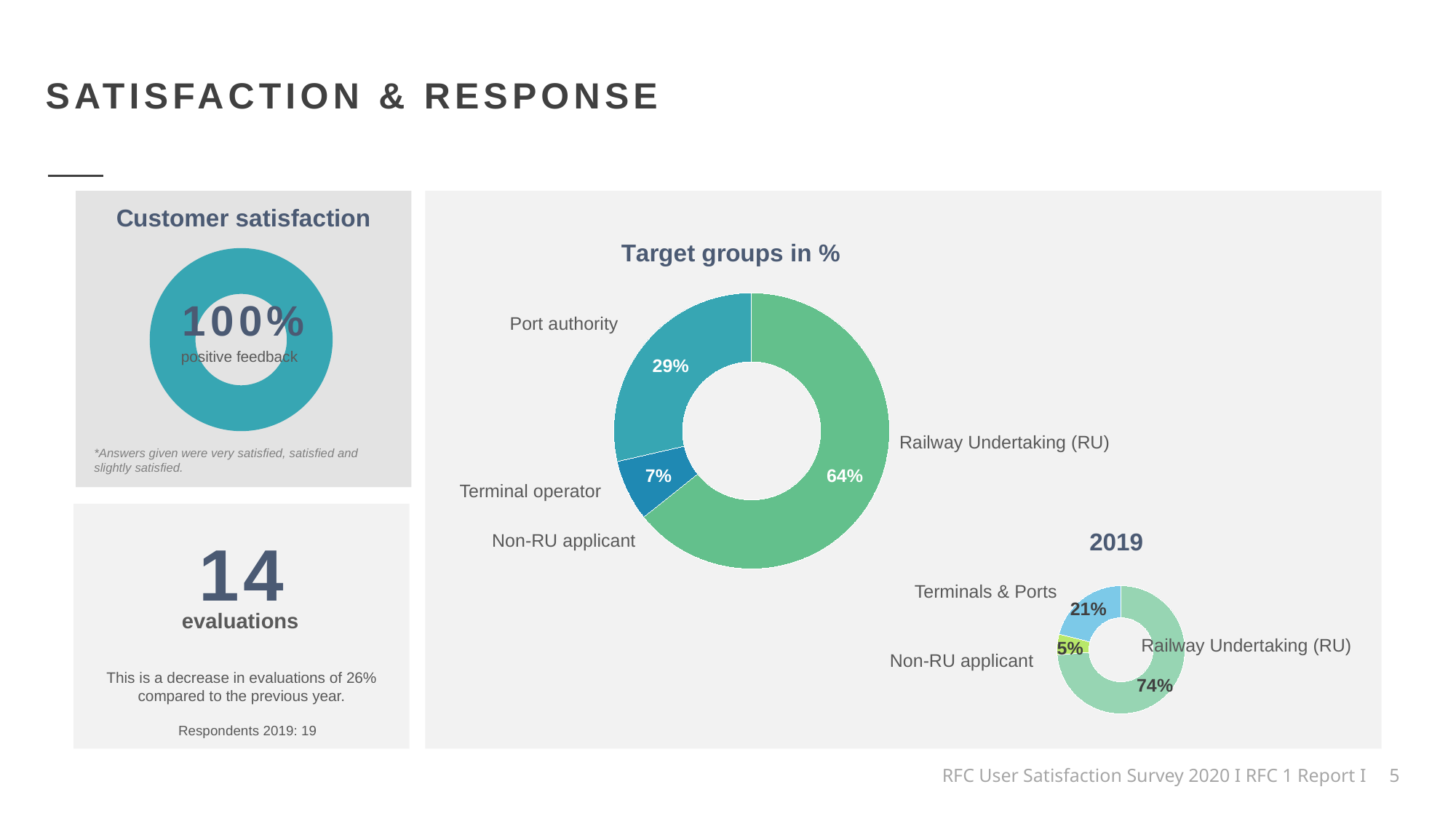
In the 'Customer satisfaction' chart, what percentage of positive feedback is shown? 100% In the 'Target groups in %' chart, what share is Port authority? 29% In the 'Target groups in %' chart, what is the difference between the Port authority share and the Terminal operator share? 22% In the 'Target groups in %' chart, which target group has the largest share? Railway Undertaking (RU) In the 2019 chart, what share is Non-RU applicant? 5% In the 'Target groups in %' chart, what share is Railway Undertaking (RU)? 64% In the 'Target groups in %' chart, what share is Terminal operator? 7% What kind of chart is the 'Target groups in %' chart? Donut (pie) chart In the 2019 chart, what share is Railway Undertaking (RU)? 74% In the 2019 chart, what share is Terminals & Ports? 21% In the 'Target groups in %' chart, which is larger: Port authority or Terminal operator? Port authority In the 2019 chart, which group has the smallest share? Non-RU applicant